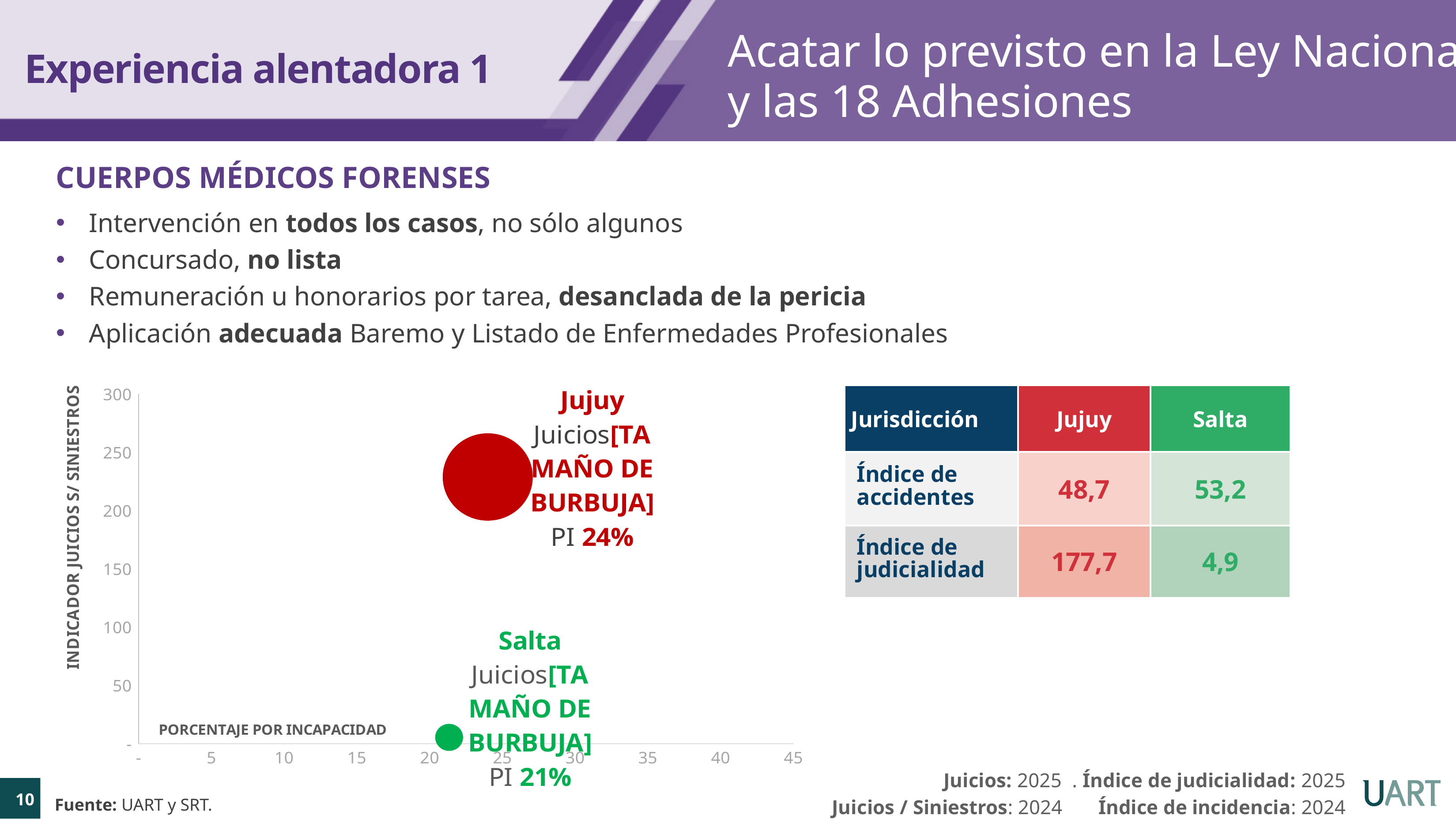
Which jurisdiction has the higher value on the 'Indicador juicios s/ siniestros' axis? Jujuy What colour is the Jujuy bubble in the chart? Red What kind of chart is shown on the slide? Bubble chart What is the PI value shown for Salta in the chart? 21% What is the PI value shown for Jujuy in the chart? 24% Which bubble is larger in size, Jujuy or Salta? Jujuy What is the label of the vertical axis of the chart? INDICADOR JUICIOS S/ SINIESTROS Is the 'Indicador juicios s/ siniestros' value for Salta greater or less than 50? less How many bubbles (jurisdictions) are plotted in the chart? 2 Which jurisdiction has the lowest value on the 'Indicador juicios s/ siniestros' axis? Salta Is the 'Indicador juicios s/ siniestros' value for Jujuy greater or less than 200? greater What is the difference between the PI values of Jujuy and Salta? 3 percentage points